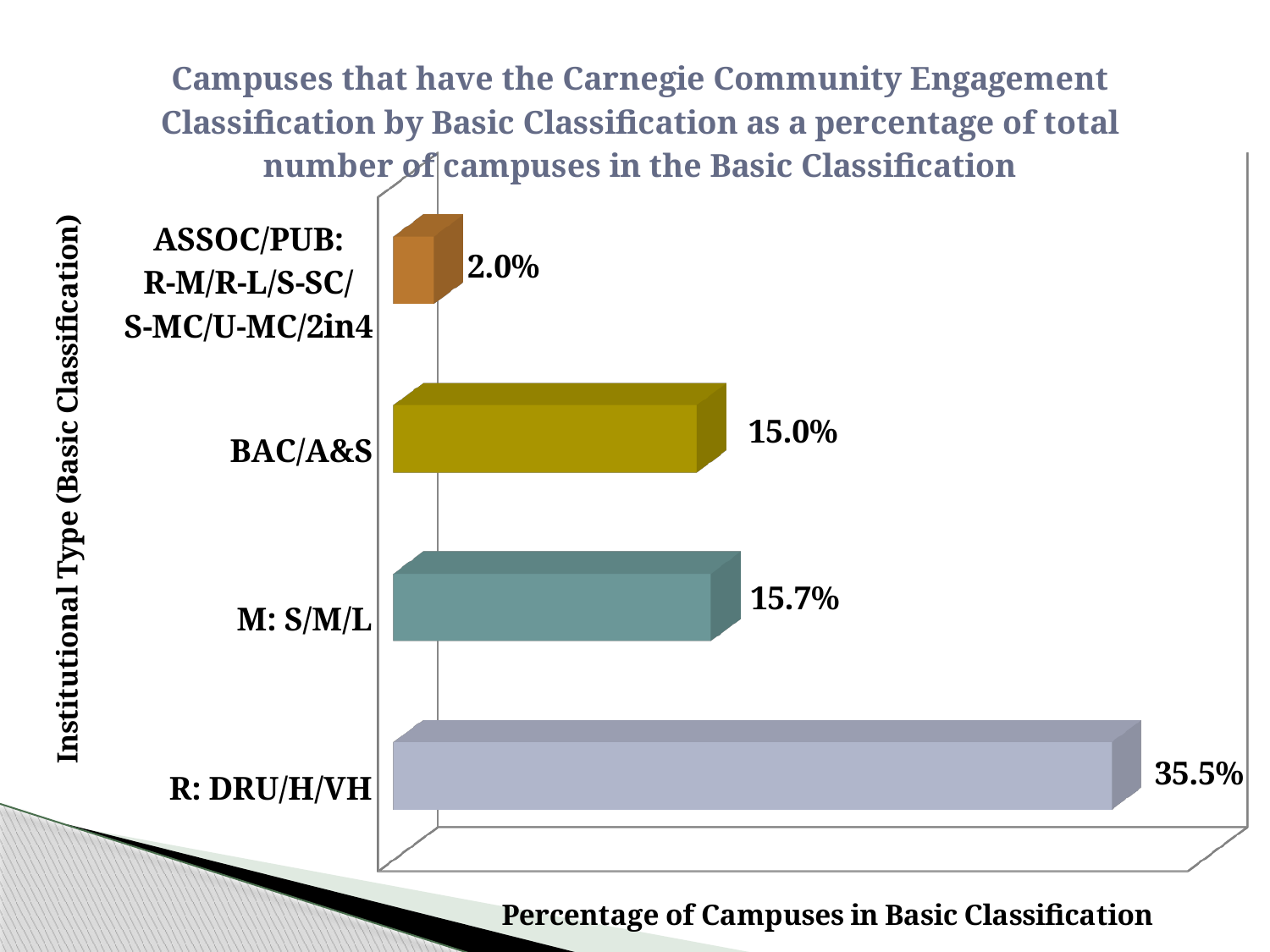
How many institutional types are shown in the chart? 4 What kind of chart is shown on the slide? Bar chart Which is larger, the value for R: DRU/H/VH or the value for BAC/A&S? R: DRU/H/VH What is the value for BAC/A&S? 15.0% What is the difference between the values for R: DRU/H/VH and M: S/M/L? 19.8% What is the value for ASSOC/PUB: R-M/R-L/S-SC/S-MC/U-MC/2in4? 2.0% What is the value for R: DRU/H/VH? 35.5% What is the difference between the values for BAC/A&S and ASSOC/PUB: R-M/R-L/S-SC/S-MC/U-MC/2in4? 13.0% Which institutional type has the lowest percentage? ASSOC/PUB: R-M/R-L/S-SC/S-MC/U-MC/2in4 What is the label of the horizontal axis? Percentage of Campuses in Basic Classification What is the value for M: S/M/L? 15.7% Which institutional type has the highest percentage? R: DRU/H/VH